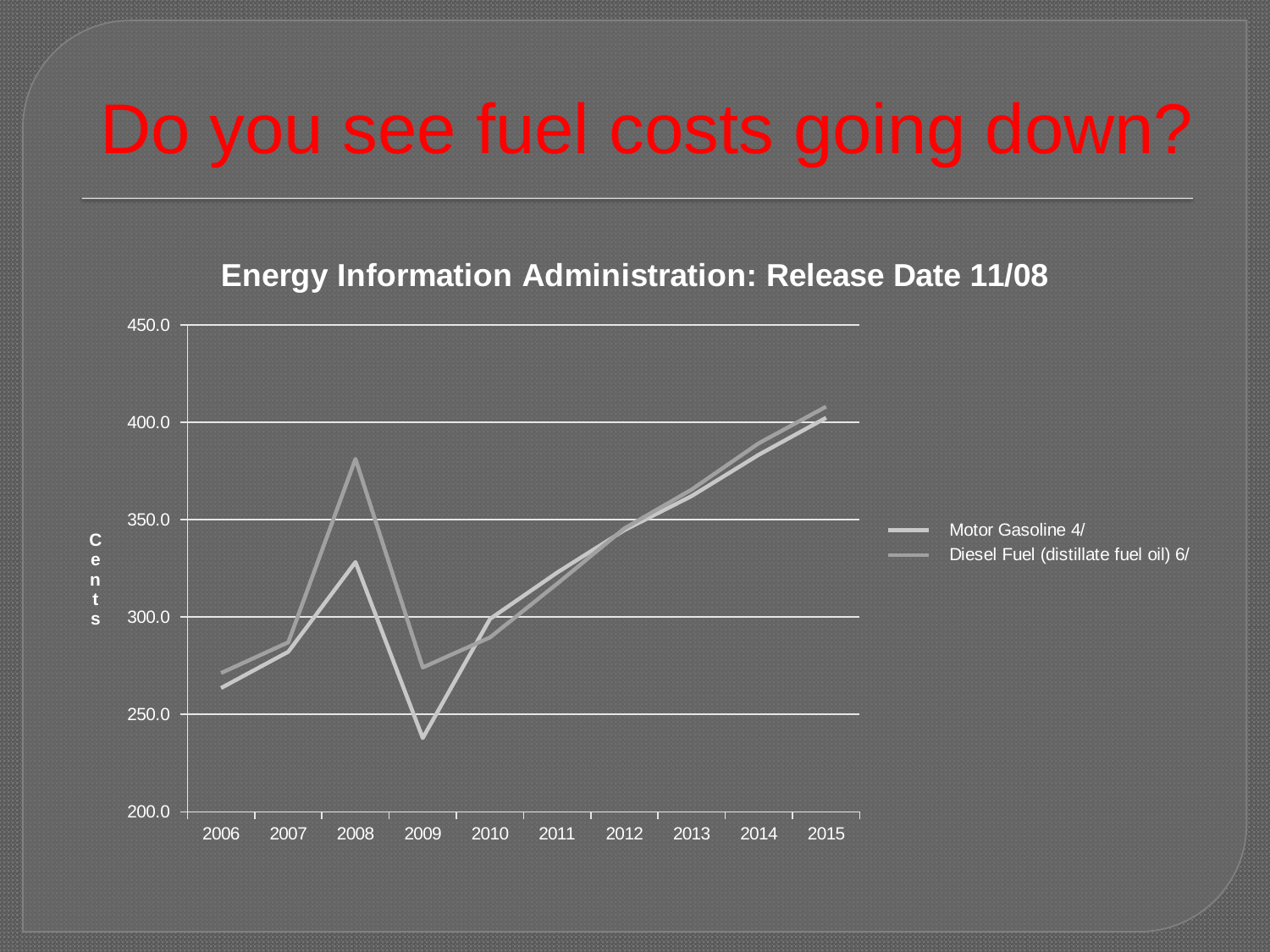
Is the higher of the two values in 2008 greater or less than 350.0? greater Are the values for both series in 2009 greater or less than 300.0? less What kind of chart is shown on the slide? line chart How many years are plotted along the x axis? 10 What unit is shown on the vertical axis label? Cents Are the values for both series in 2014 greater or less than 350.0? greater In which year do both series reach their highest value? 2015 What is the title of the chart? Energy Information Administration: Release Date 11/08 Do the values rise or fall from 2009 to 2015? rise How many series does the legend list? 2